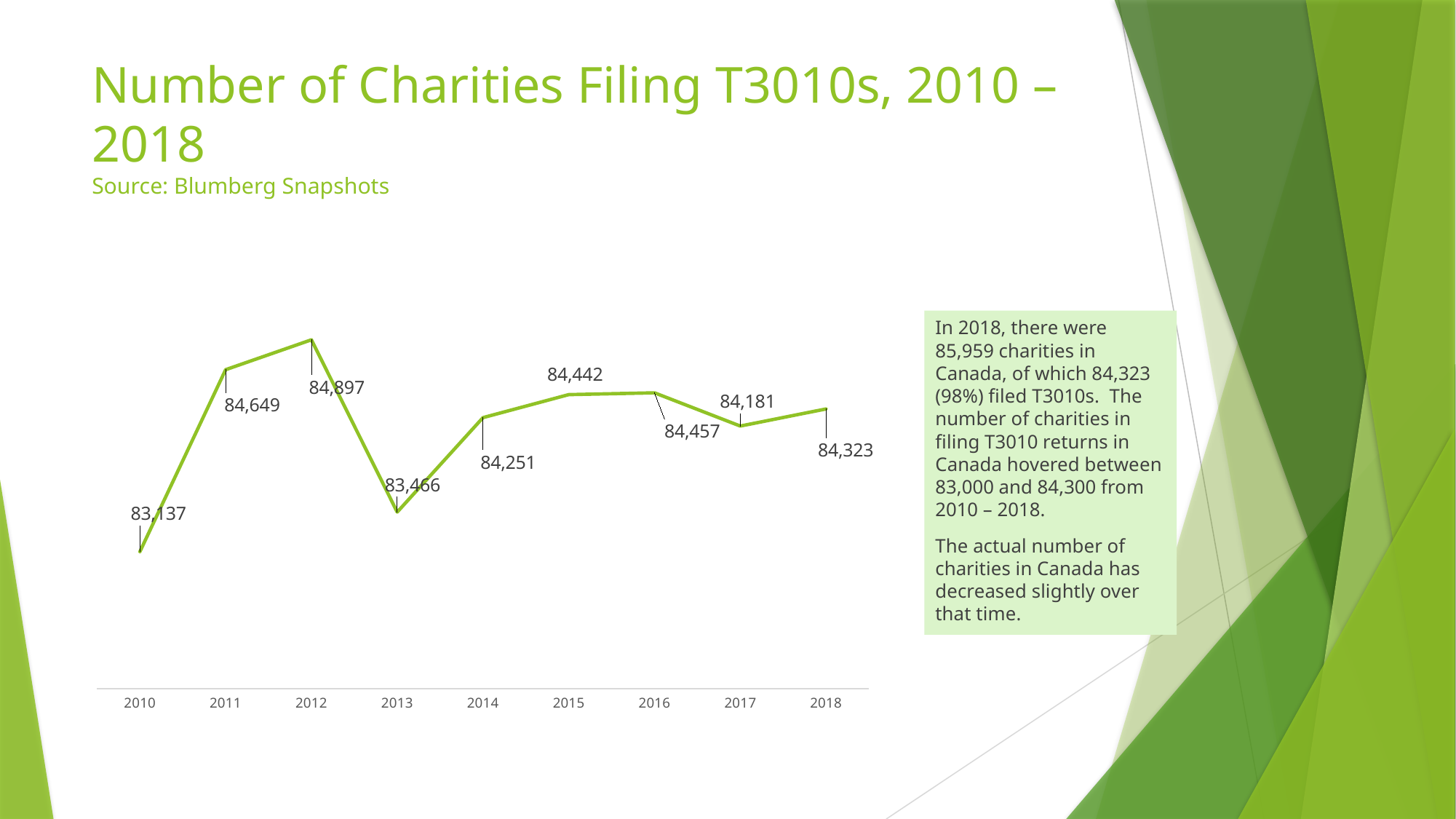
What is the number of charities filing T3010s in 2010? 83,137 What is the number of charities filing T3010s in 2015? 84,442 What is the number of charities filing T3010s in 2018? 84,323 Which year has the lowest number of charities filing T3010s? 2010 What kind of chart is shown on the slide? Line chart Which year had more charities filing T3010s, 2011 or 2013? 2011 What is the difference between the number of charities filing in 2014 and in 2013? 785 What is the number of charities filing T3010s in 2013? 83,466 Does the number of charities filing T3010s rise or fall from 2012 to 2013? Fall What is the difference between the number of charities filing in 2012 and in 2010? 1,760 Which year has the highest number of charities filing T3010s? 2012 How many years are plotted on the chart? 9